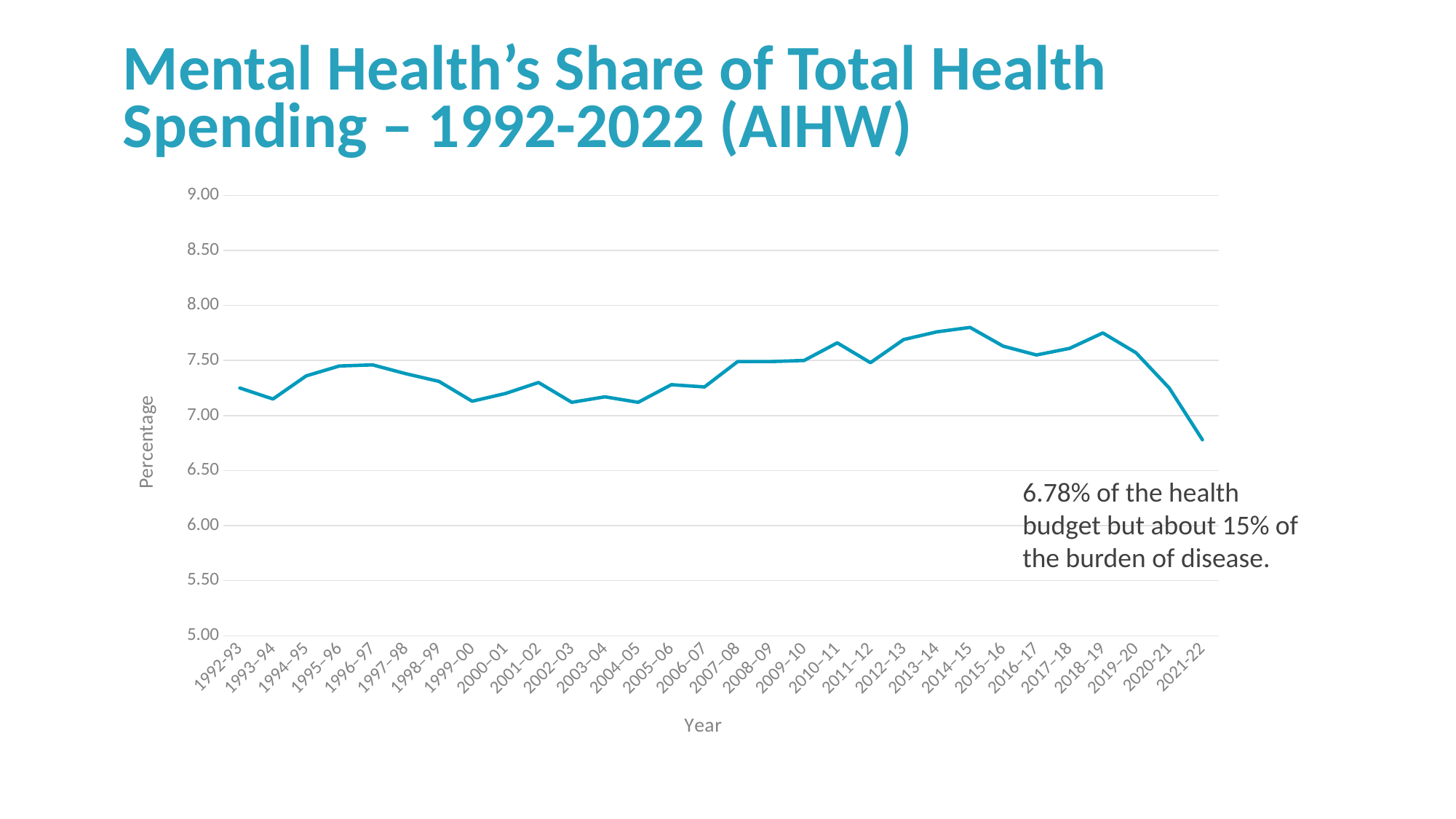
Is the value for 2014-15 greater or less than 7.50? greater How many years are plotted along the x axis? 30 Which is larger, the value for 2014-15 or the value for 1992-93? 2014-15 Is the value for 1999-00 greater or less than 7.50? less What is the title of the chart on the slide? Mental Health's Share of Total Health Spending – 1992-2022 (AIHW) What kind of chart is shown on the slide? line chart What is the label on the vertical axis? Percentage Do the values rise or fall from 2018-19 to 2021-22? fall Is the value for 1992-93 greater or less than 7.00? greater Which year has the lowest mental health share of total health spending? 2021-22 What is the mental health share of the health budget in 2021-22, as stated on the slide? 6.78%